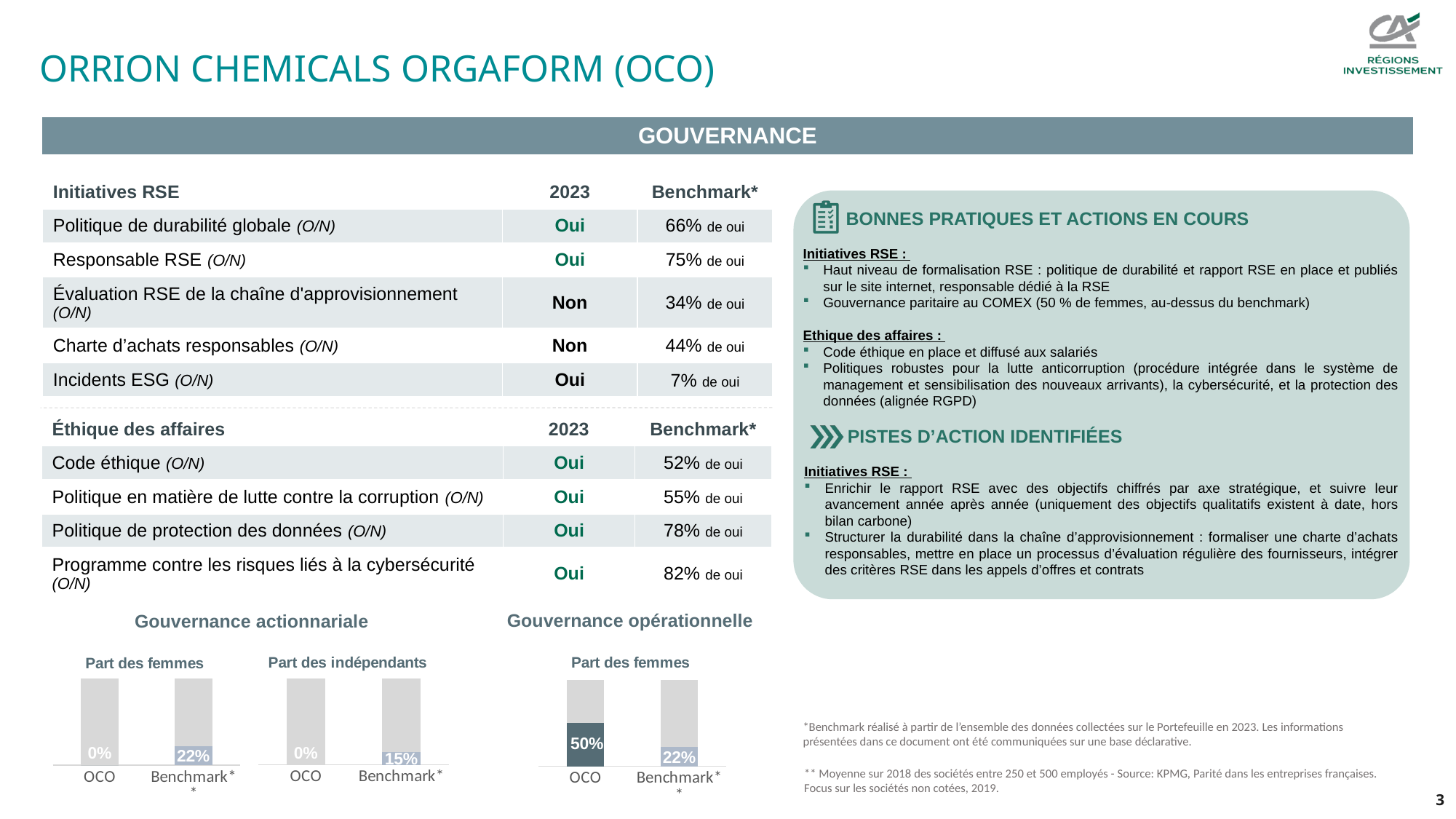
In the 'Part des femmes' chart under 'Gouvernance actionnariale', what is the value for Benchmark**? 22% In the 'Part des femmes' chart under 'Gouvernance opérationnelle', what is the value for Benchmark**? 22% In the 'Part des indépendants' chart, what is the value for Benchmark**? 15% What type of chart is the 'Part des indépendants' chart? Bar chart In the 'Part des femmes' chart under 'Gouvernance opérationnelle', what is the value for OCO? 50% In the 'Part des femmes' chart under 'Gouvernance actionnariale', which category has the lowest value? OCO How many categories are shown in the 'Part des indépendants' chart? 2 In the 'Part des femmes' chart under 'Gouvernance opérationnelle', which category has the higher value, OCO or Benchmark**? OCO In the 'Part des indépendants' chart, what is the value for OCO? 0% In the 'Part des femmes' chart under 'Gouvernance actionnariale', what is the value for OCO? 0% In the 'Part des femmes' chart under 'Gouvernance opérationnelle', what is the difference between the OCO value and the Benchmark** value? 28% In the 'Part des indépendants' chart, what is the difference between the Benchmark** value and the OCO value? 15%